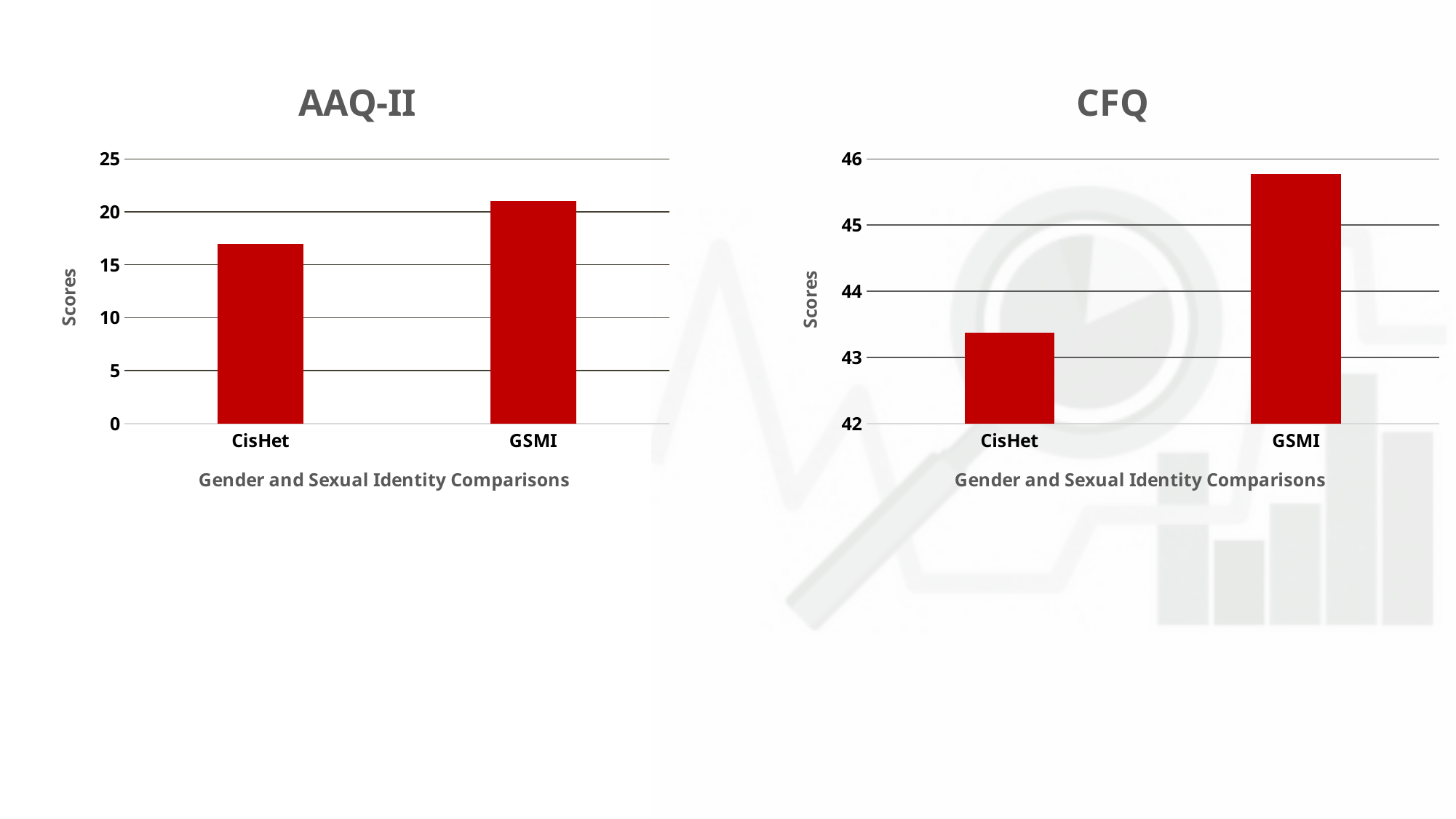
In the AAQ-II chart, which category has the highest score? GSMI In the CFQ chart, which is larger, the value for CisHet or the value for GSMI? GSMI In the CFQ chart, which category has the highest score? GSMI In the AAQ-II chart, is the value for CisHet greater or less than 15? greater How many categories are shown in the AAQ-II chart? 2 In the CFQ chart, is the value for GSMI greater or less than 45? greater In the CFQ chart, is the value for CisHet greater or less than 44? less What is the x-axis title of the AAQ-II chart? Gender and Sexual Identity Comparisons In the AAQ-II chart, which category has the lowest score? CisHet What kind of chart is the CFQ chart? Bar chart